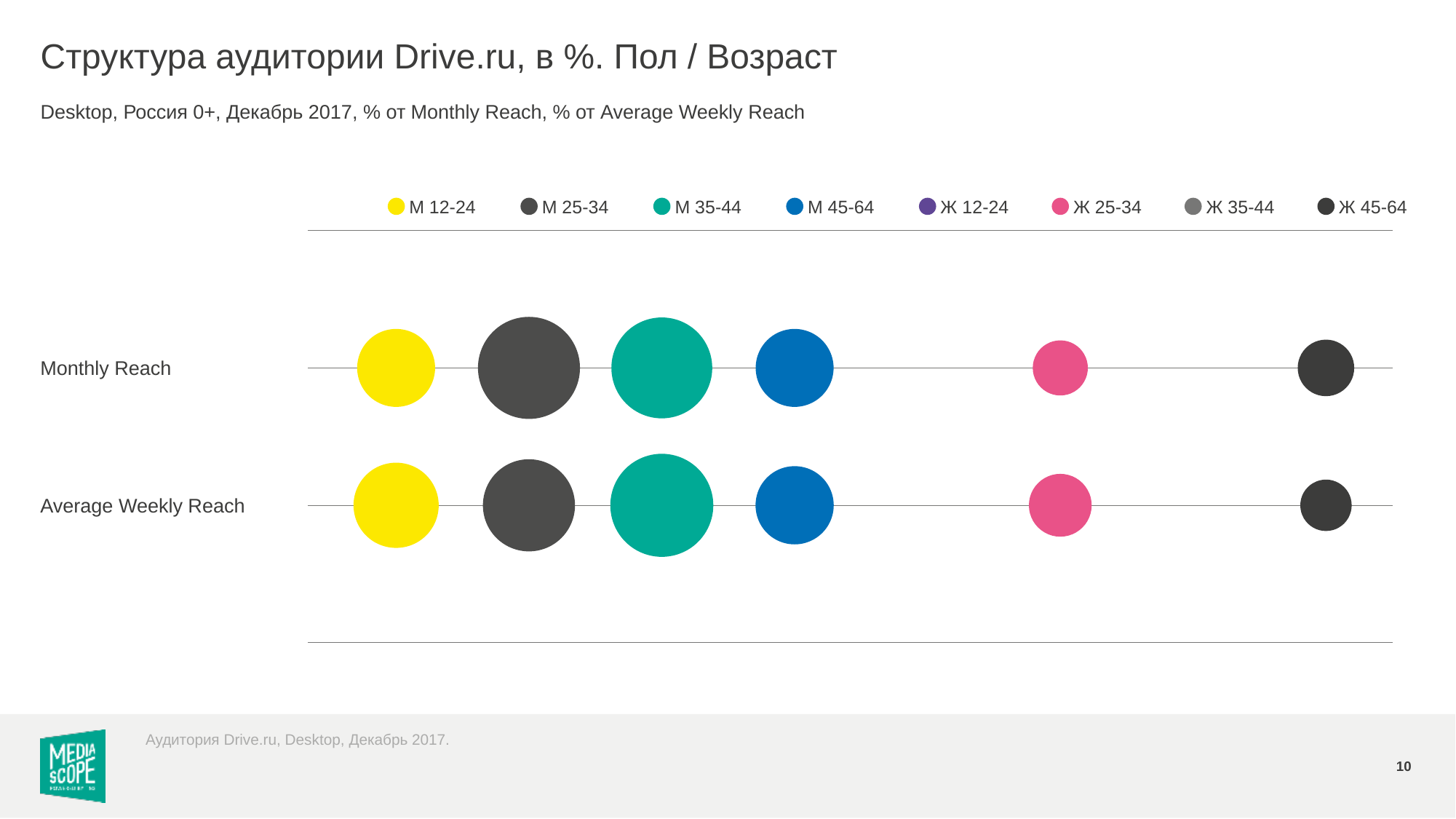
In the Monthly Reach row, which bubble is larger: М 25-34 or М 45-64? М 25-34 How many bubbles are visible in the Monthly Reach row? 6 Which age/gender group has the largest bubble in the Average Weekly Reach row? М 35-44 In the Average Weekly Reach row, which bubble is larger: М 12-24 or М 35-44? М 35-44 How many series does the legend list? 8 What are the two row labels on the chart? Monthly Reach, Average Weekly Reach Which colour represents М 35-44 in the legend? Teal (green) What kind of chart is shown on the slide? Bubble chart In the Monthly Reach row, which bubble is larger: М 45-64 or Ж 25-34? М 45-64 How many rows (categories) are plotted on the chart? 2